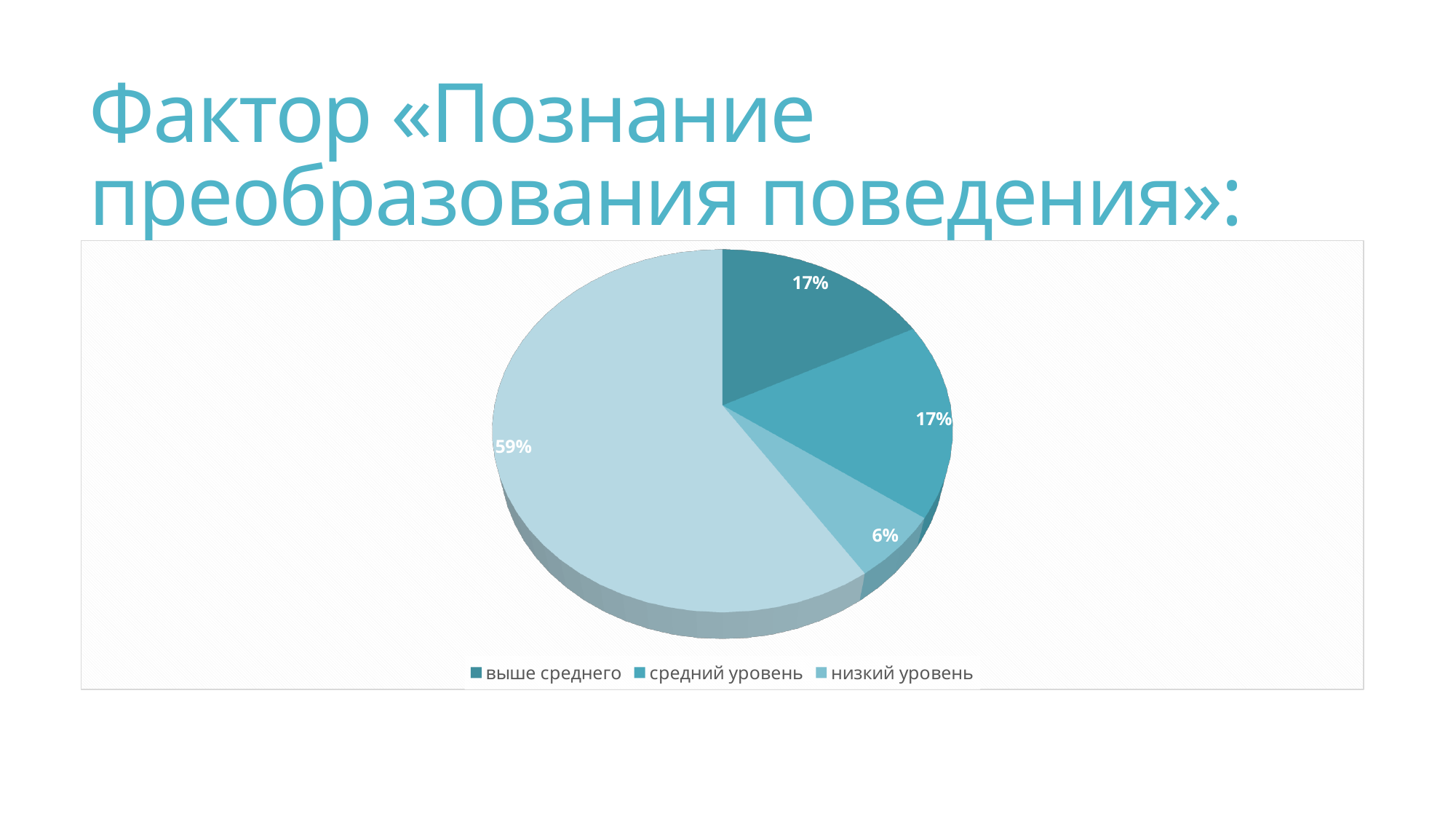
Is the largest slice of the pie greater or less than 50%? greater Which is larger: the 59% slice or the 6% slice? the 59% slice How many entries does the legend list? 3 What is the combined share of the two slices labelled 17%? 34% What is the title of the slide? Фактор «Познание преобразования поведения»: What is the value for "средний уровень"? 17% How many slices does the pie chart have? 4 What kind of chart is shown on the slide? pie chart What is the value for "выше среднего"? 17% What is the value of the smallest slice of the pie? 6% What is the difference between the largest slice (59%) and the smallest slice (6%)? 53% What is the value of the largest slice of the pie? 59%